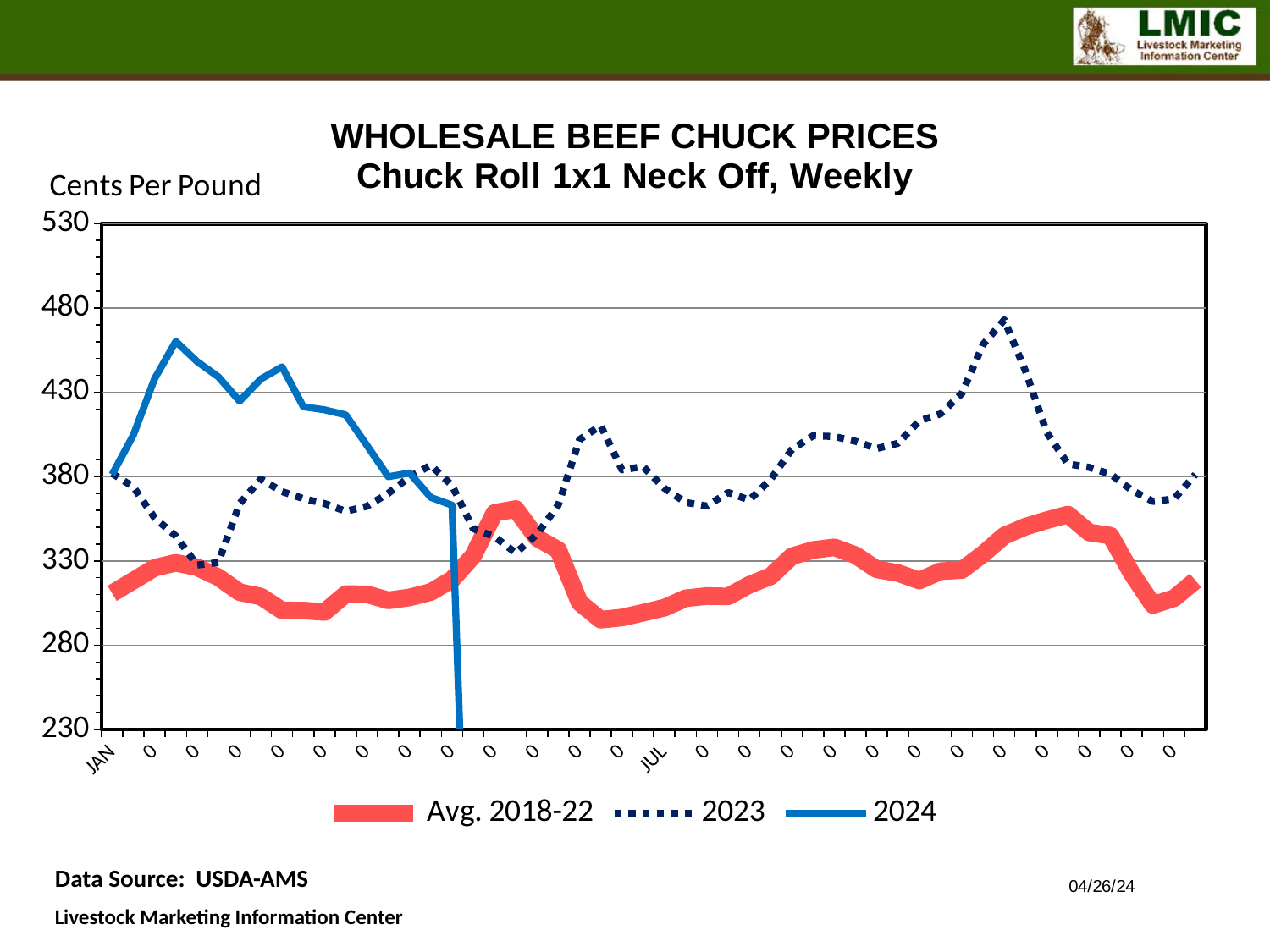
Is the lowest value of the Avg. 2018-22 series greater or less than 330? less Is the value of the Avg. 2018-22 series at JAN greater or less than 330? less What is the subtitle of the chart below 'WHOLESALE BEEF CHUCK PRICES'? Chuck Roll 1x1 Neck Off, Weekly How many series does the legend list? 3 What kind of chart is shown on the slide? Line chart Is the highest value of the 2023 series greater or less than 480? less Which series reaches the highest value anywhere on the chart? 2023 Does the 2024 series rise or fall from its early-February peak to its last plotted point? Fall What unit is shown on the y axis of the chart? Cents Per Pound Does the 2023 series rise or fall from JUL to its peak in the autumn? Rise At JAN, which series is higher: 2024 or Avg. 2018-22? 2024